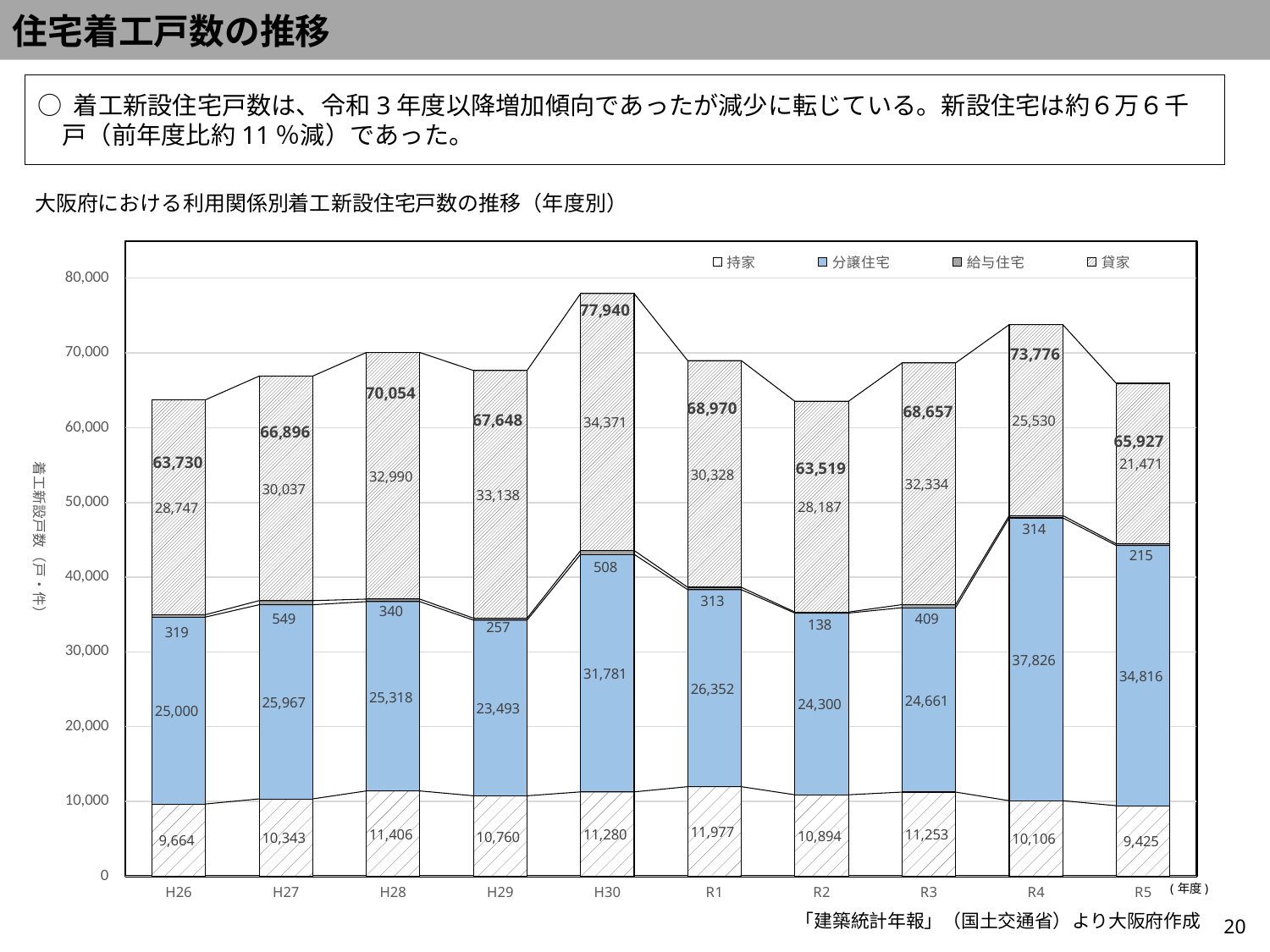
What is the total number of new housing starts for H30? 77,940 What kind of chart is shown on the slide? Stacked bar chart How many series does the legend list? 4 What is the value for 給与住宅 in R2? 138 What is the difference between the 貸家 value in H30 and the 貸家 value in R5? 12,900 What is the value for 分譲住宅 in R4? 37,826 Does the 分譲住宅 value rise or fall from R2 to R4? Rise Which is larger, the 持家 value in R1 or the 持家 value in R5? R1 Which fiscal year has the lowest total number of new housing starts? R2 How many fiscal years are shown on the x axis? 10 What is the title of the chart? 大阪府における利用関係別着工新設住宅戸数の推移（年度別） Which fiscal year has the highest total number of new housing starts? H30